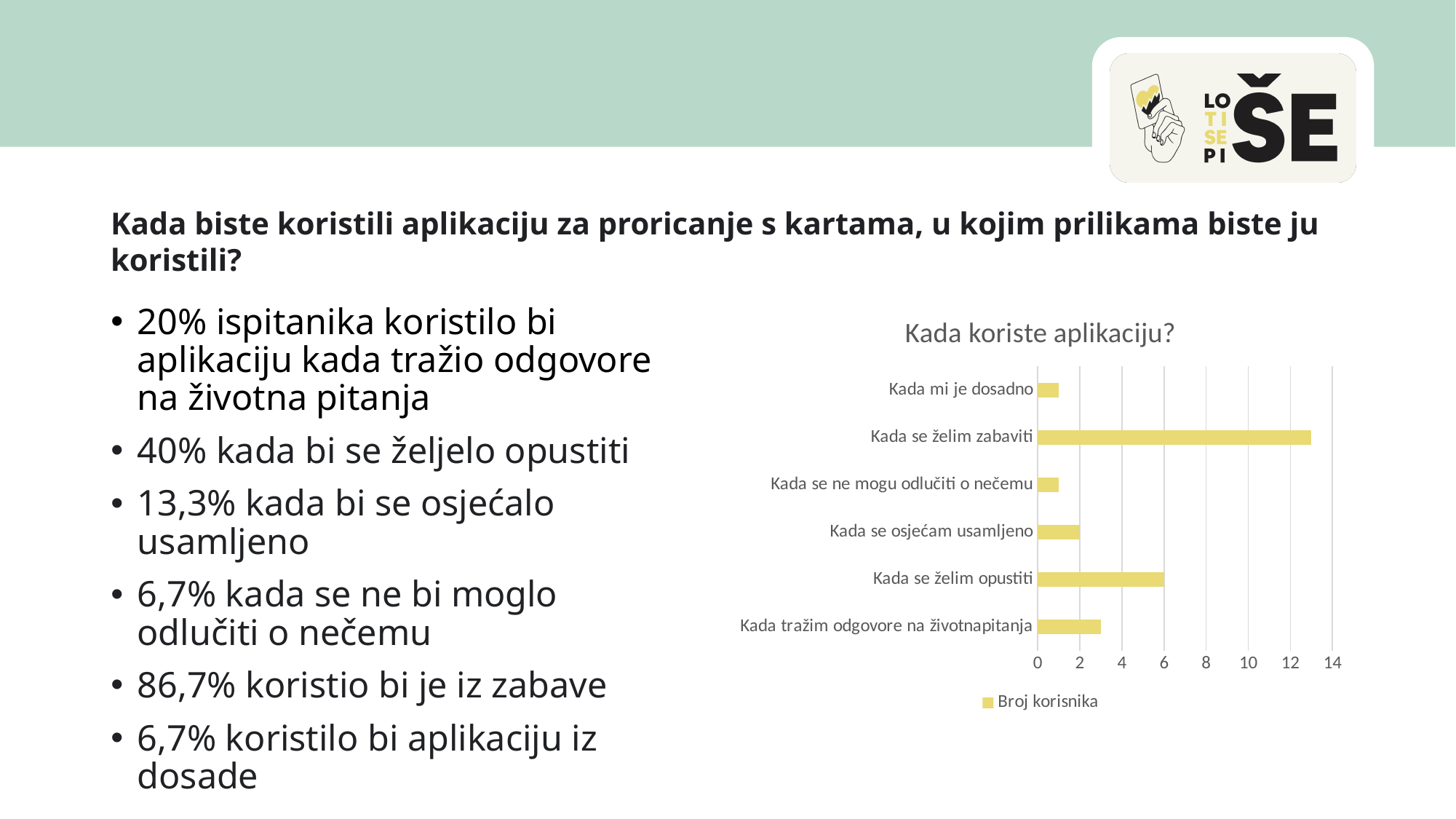
What is the title of the chart? Kada koriste aplikaciju? How many series does the chart's legend list? 1 How many categories does the chart show? 6 Is the value for "Kada mi je dosadno" greater or less than 2? less Is the value for "Kada tražim odgovore na životna pitanja" greater or less than 4? less What is the name of the series in the chart's legend? Broj korisnika Which is larger: the value for "Kada se želim opustiti" or for "Kada se osjećam usamljeno"? Kada se želim opustiti Is the value for "Kada se želim zabaviti" greater or less than 12? greater Which category has the highest value in the chart? Kada se želim zabaviti What is the value for "Kada se osjećam usamljeno"? 2 What kind of chart is shown on the slide? bar chart What is the value for "Kada se želim opustiti"? 6